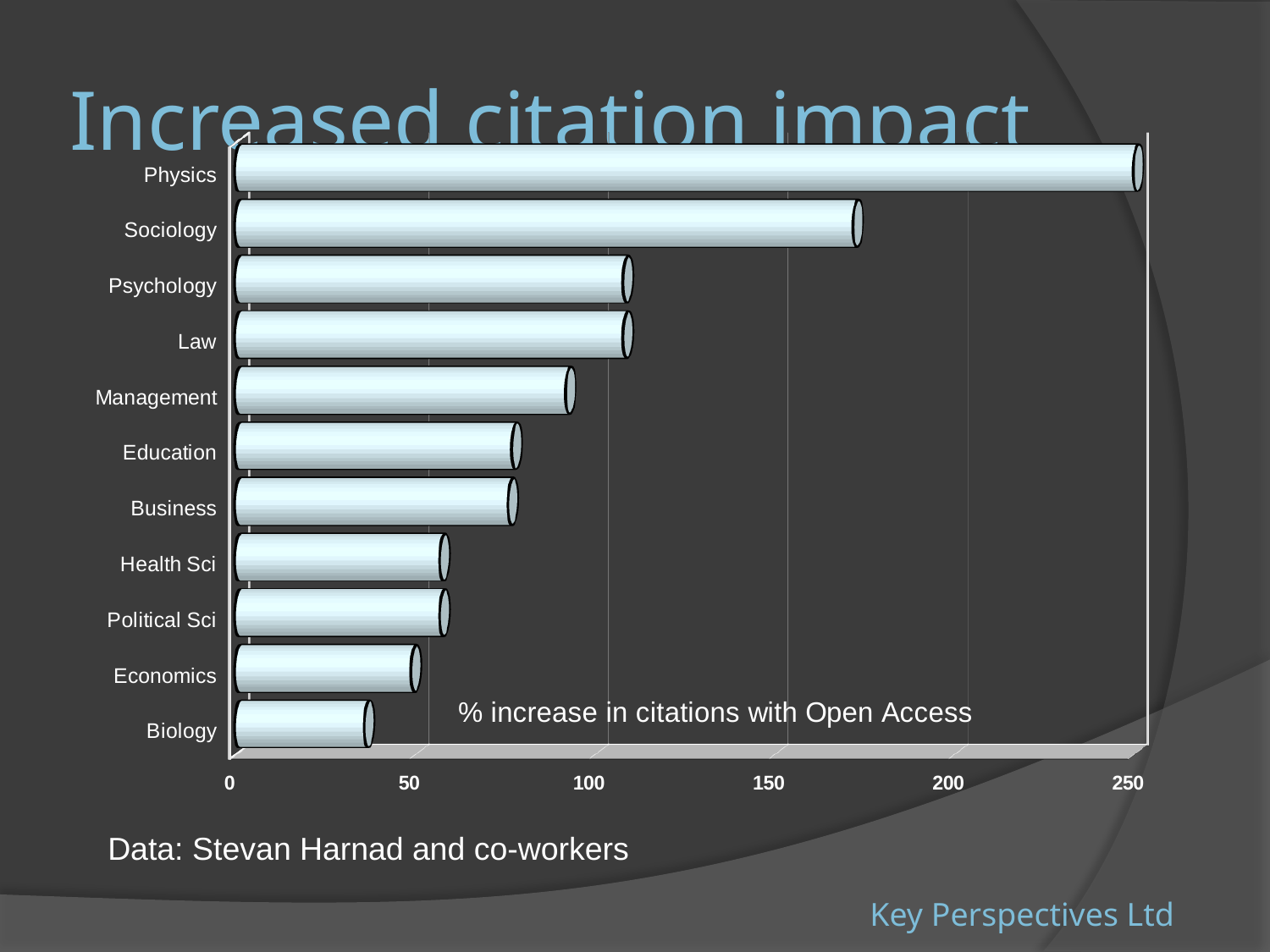
Is the value for Management greater or less than 100? less Which has a larger % increase in citations, Sociology or Psychology? Sociology Which discipline has the lowest % increase in citations with Open Access? Biology Which discipline has the highest % increase in citations with Open Access? Physics Is the value for Physics greater or less than 200? greater How many disciplines are plotted in the chart? 11 Is the value for Sociology greater or less than 150? greater What kind of chart is shown on the slide? bar chart Which has a larger % increase in citations, Management or Health Sci? Management What is the title of the slide containing the chart? Increased citation impact